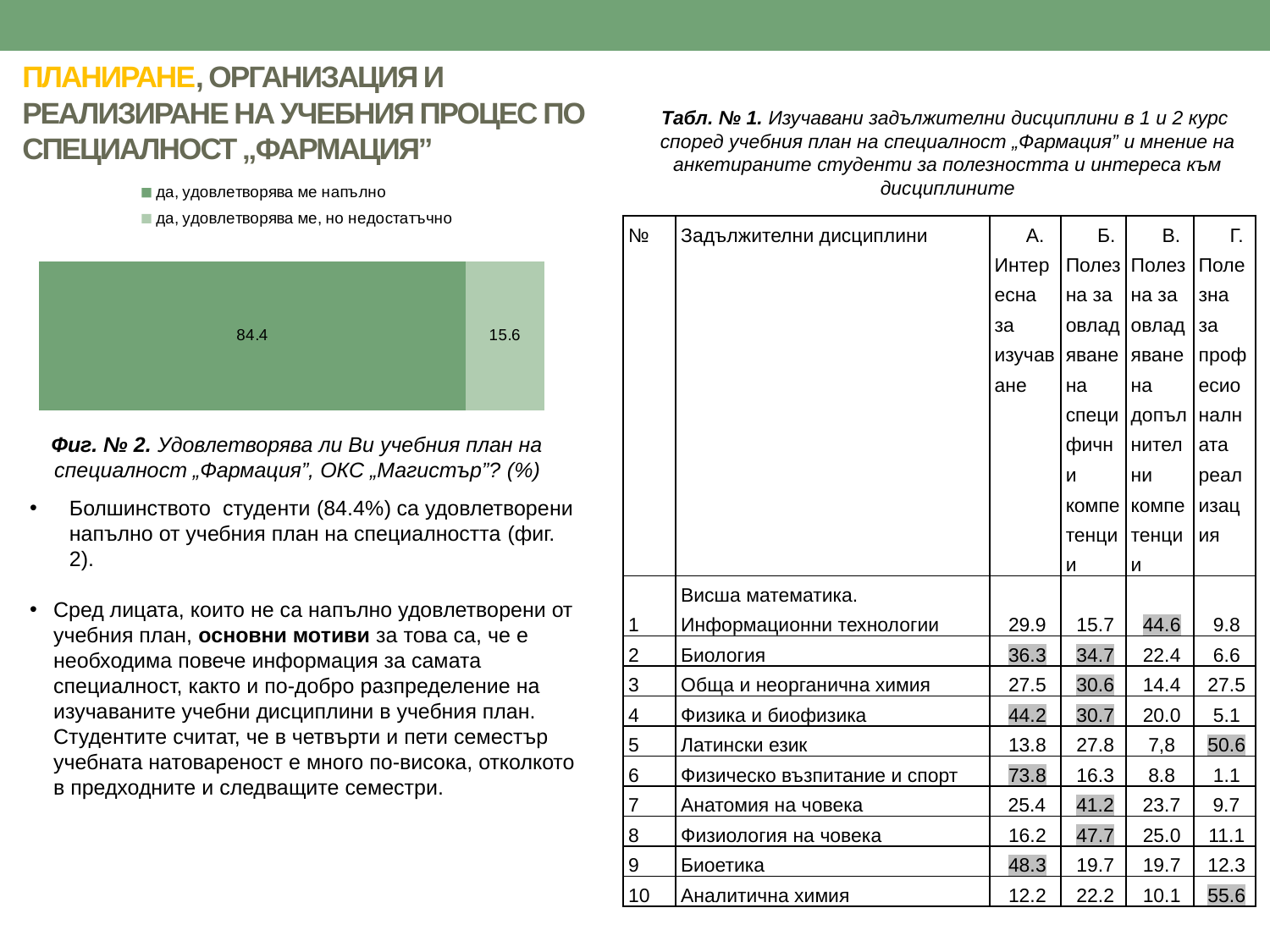
Is the value for "да, удовлетворява ме напълно" larger or smaller than the value for "да, удовлетворява ме, но недостатъчно"? larger What value is shown for the series "да, удовлетворява ме напълно" in the bar chart? 84.4 Which series is shown in the darker green colour in the bar chart? да, удовлетворява ме напълно Which series has the smaller value in the bar chart? да, удовлетворява ме, но недостатъчно Which series has the larger value in the bar chart? да, удовлетворява ме напълно What kind of chart is shown on the left of the slide? bar chart What value is shown for the series "да, удовлетворява ме, но недостатъчно" in the bar chart? 15.6 How many series does the legend of the bar chart list? 2 What is the total of the two segments in the stacked bar? 100 What is the caption of the chart on the slide? Фиг. № 2. Удовлетворява ли Ви учебния план на специалност „Фармация", ОКС „Магистър"? (%) What is the difference between the two values shown in the bar chart? 68.8